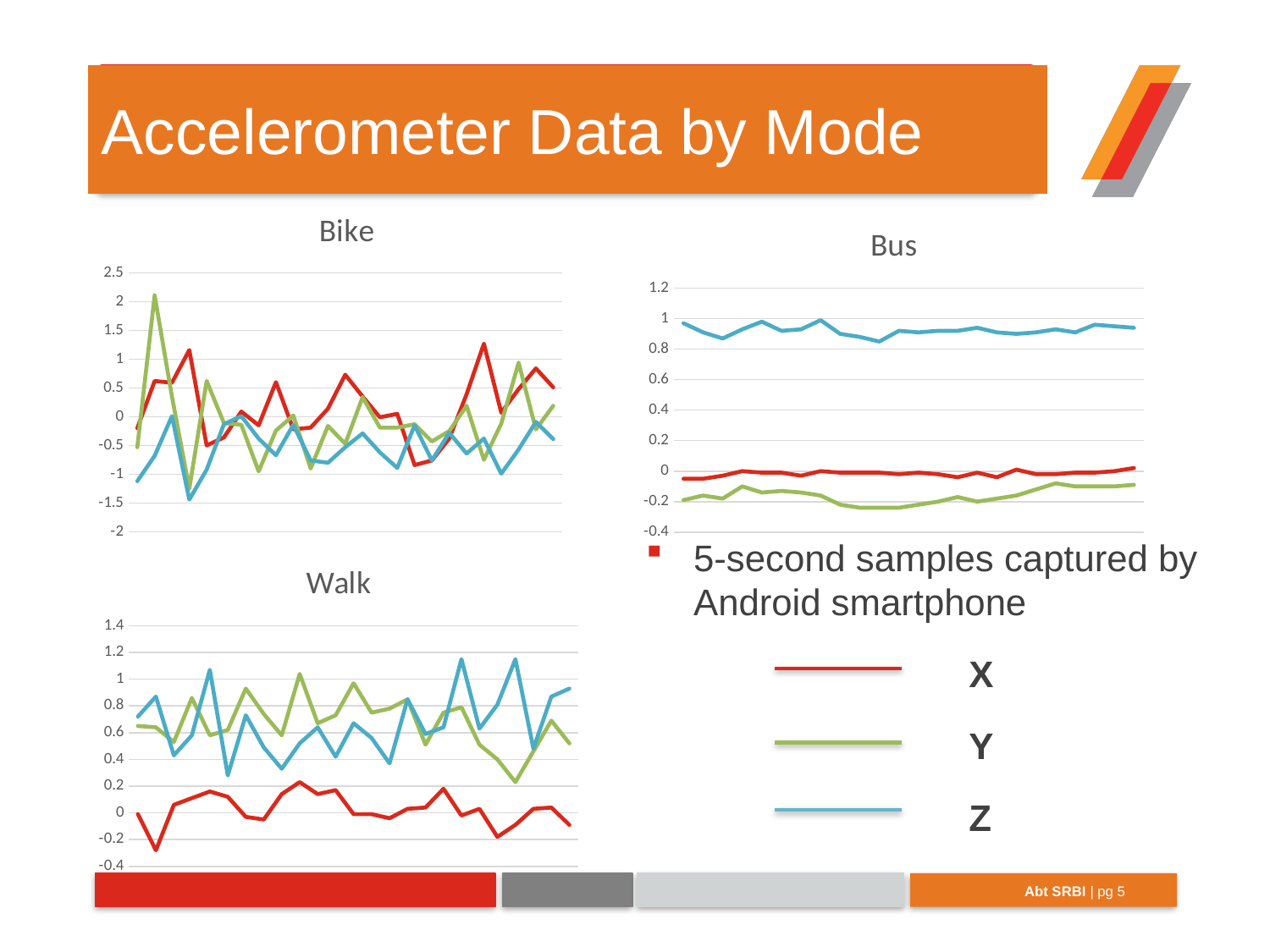
In the Walk chart, which series has the lowest values? X In the Bus chart, are the values of the Y series greater or less than 0? less In the Bike chart, is the highest peak of the Y series greater or less than 1.5? greater In the Bus chart, which series has the lowest values? Y In the Bus chart, which series has the highest values? Z In the Bus chart, are the values of the Z series greater or less than 0.6? greater How many series does the legend list for the charts? 3 What are the names of the series shown in the legend? X, Y, Z What kind of chart is the Bike chart? line chart What are the titles of the three charts on the slide? Bike, Bus, Walk In the Bus chart, which series is larger, Z or X? Z